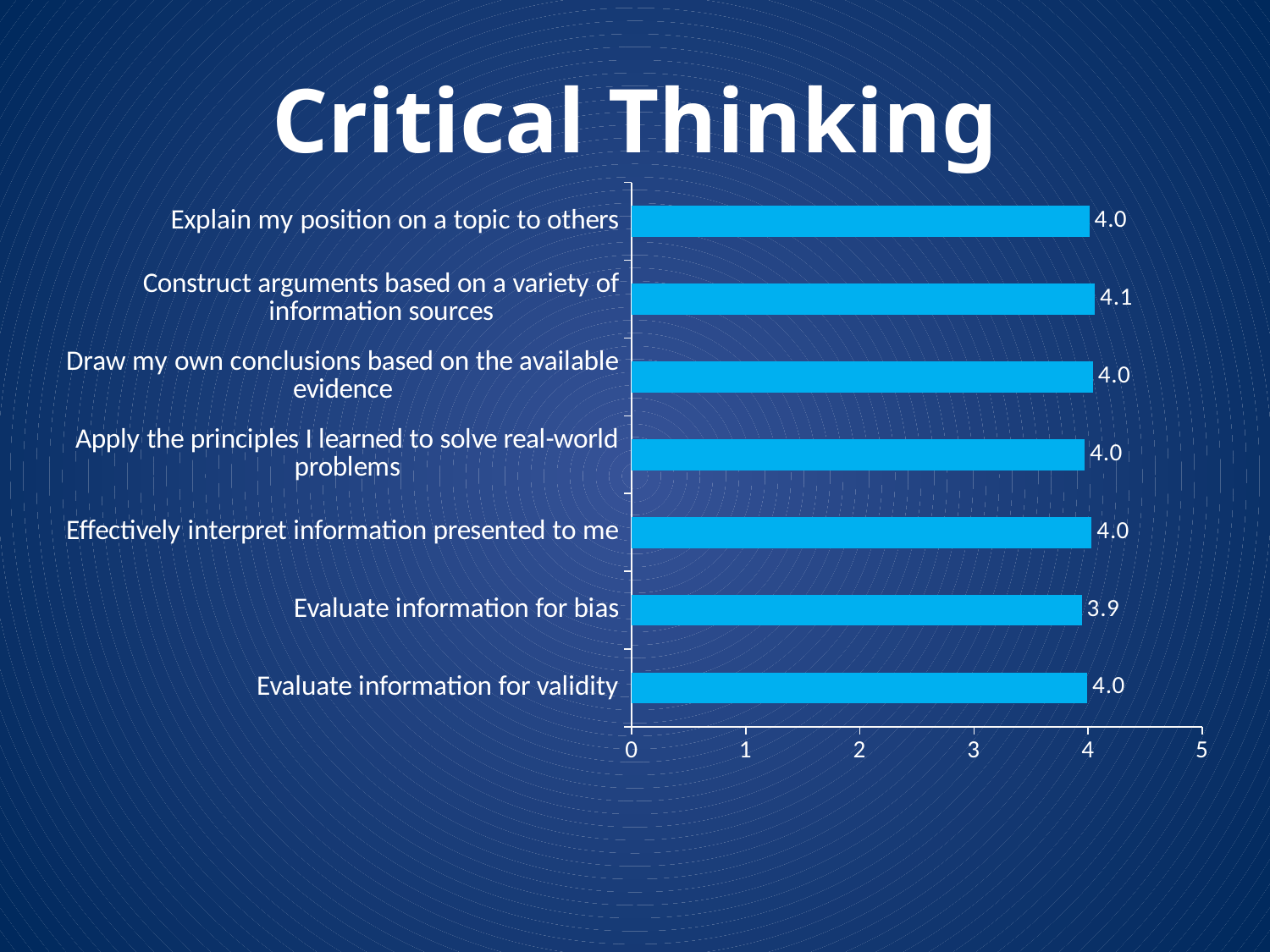
Which category has the lowest value? Evaluate information for bias What is the value for "Evaluate information for bias"? 3.9 What is the value for "Evaluate information for validity"? 4.0 Is the value for "Evaluate information for bias" greater or less than 3? greater What is the value for "Construct arguments based on a variety of information sources"? 4.1 What is the value for "Explain my position on a topic to others"? 4.0 What is the difference between the values for "Construct arguments based on a variety of information sources" and "Evaluate information for bias"? 0.2 How many categories are shown in the chart? 7 What is the title of the slide? Critical Thinking Which is larger, the value for "Construct arguments based on a variety of information sources" or the value for "Evaluate information for bias"? Construct arguments based on a variety of information sources Which category has the highest value? Construct arguments based on a variety of information sources What kind of chart is shown on the slide? Bar chart